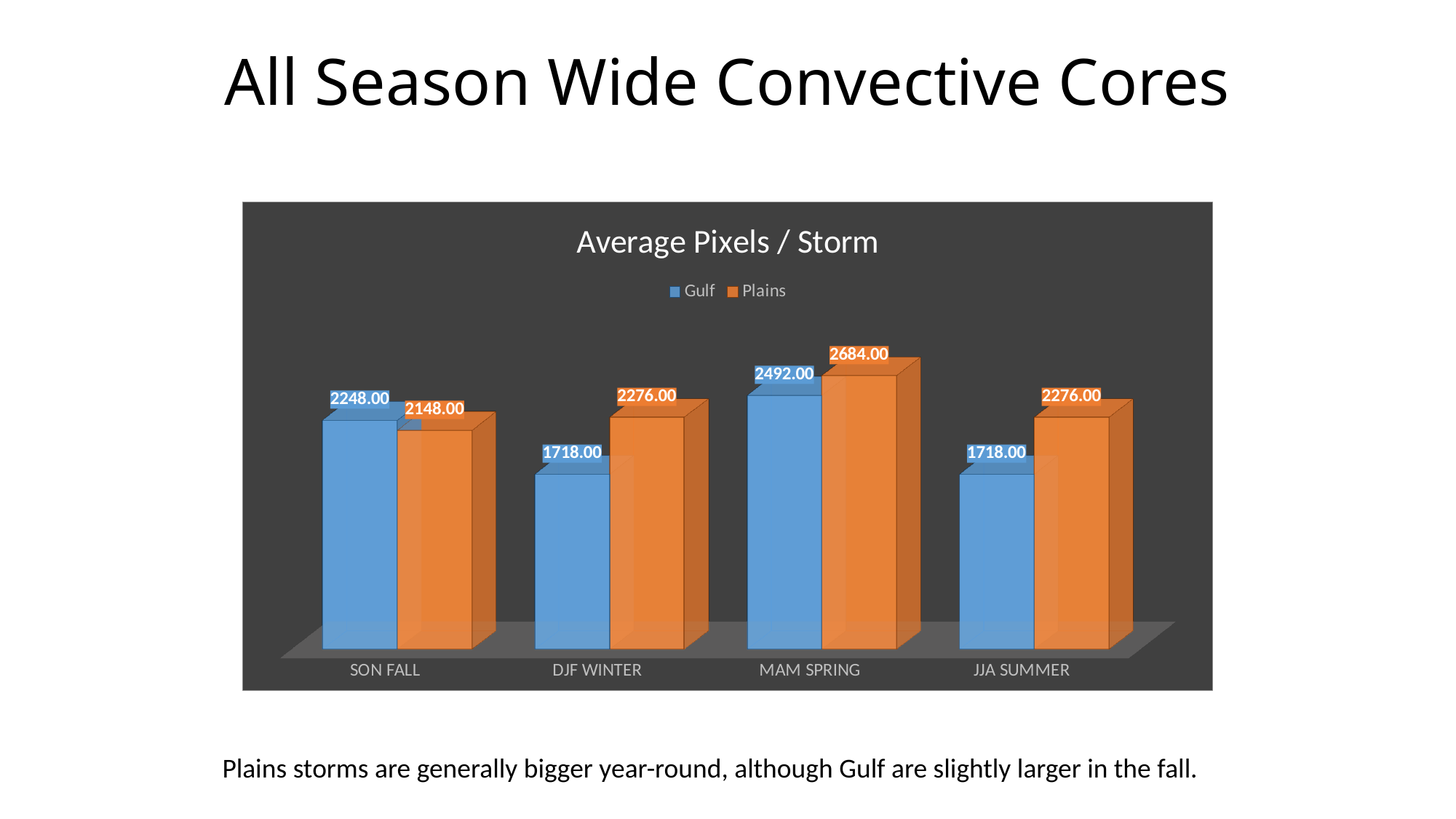
Which season has the highest Gulf value? MAM SPRING What is the Plains value for JJA SUMMER? 2276.00 What is the Gulf value for SON FALL? 2248.00 What is the difference between the Gulf and Plains values for SON FALL? 100.00 Which season has the lowest Plains value? SON FALL How many seasons are shown on the x axis? 4 What is the Plains value for MAM SPRING? 2684.00 What is the difference between the Plains and Gulf values for MAM SPRING? 192.00 For JJA SUMMER, which is larger, Gulf or Plains? Plains What is the Gulf value for DJF WINTER? 1718.00 How many series does the legend list? 2 What kind of chart is shown? Bar chart